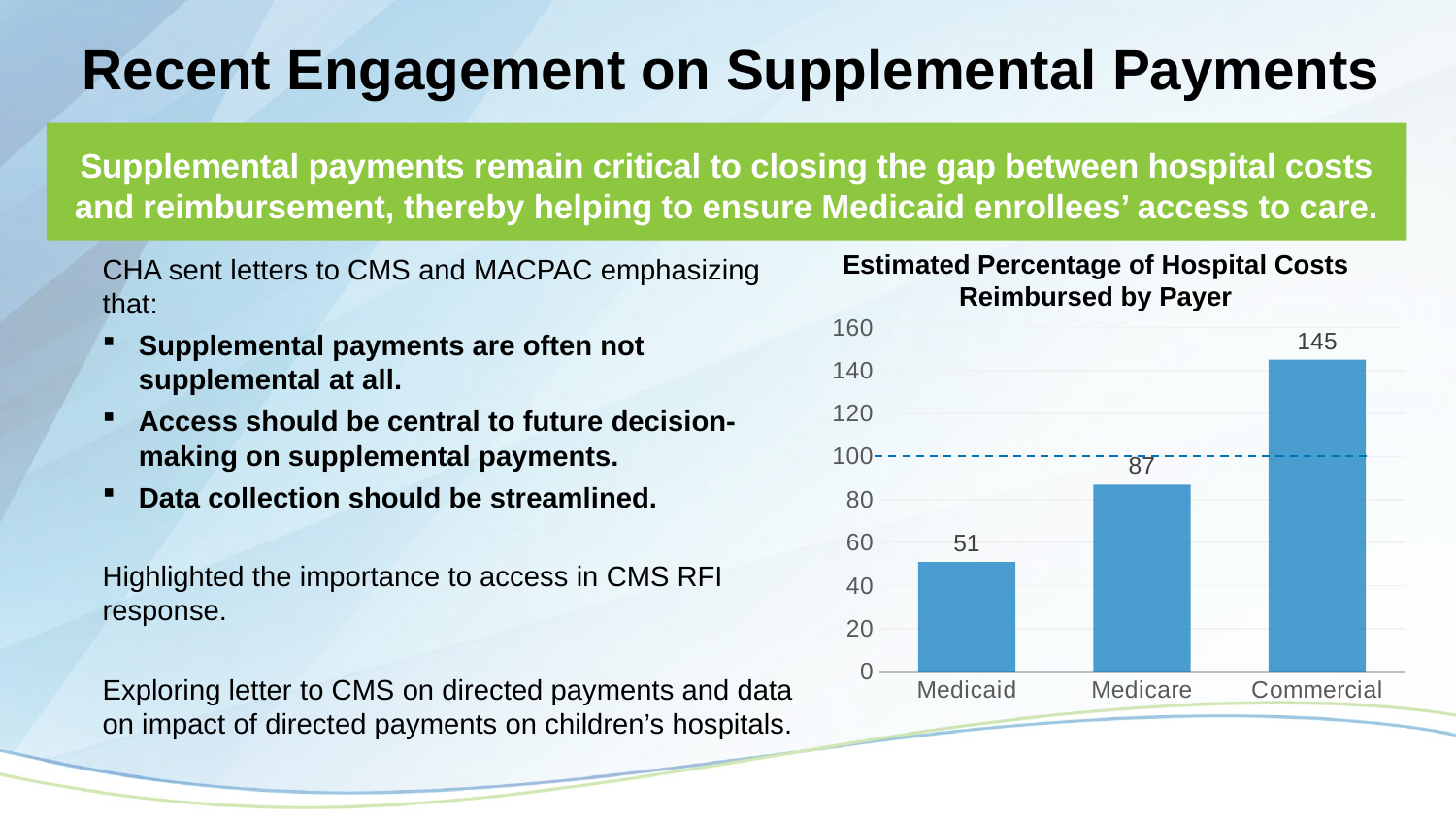
What is the value for Commercial? 145 What is the difference between the values for Commercial and Medicaid? 94 How many payer categories are shown in the chart? 3 What is the difference between the values for Medicare and Medicaid? 36 Which payer has the lowest estimated percentage of hospital costs reimbursed? Medicaid What is the value for Medicare? 87 What is the value for Medicaid? 51 What is the title of the chart? Estimated Percentage of Hospital Costs Reimbursed by Payer Which is larger, the value for Medicare or the value for Commercial? Commercial Is the value for Medicare greater or less than 100? less What kind of chart is shown on the slide? Bar chart Which payer has the highest estimated percentage of hospital costs reimbursed? Commercial